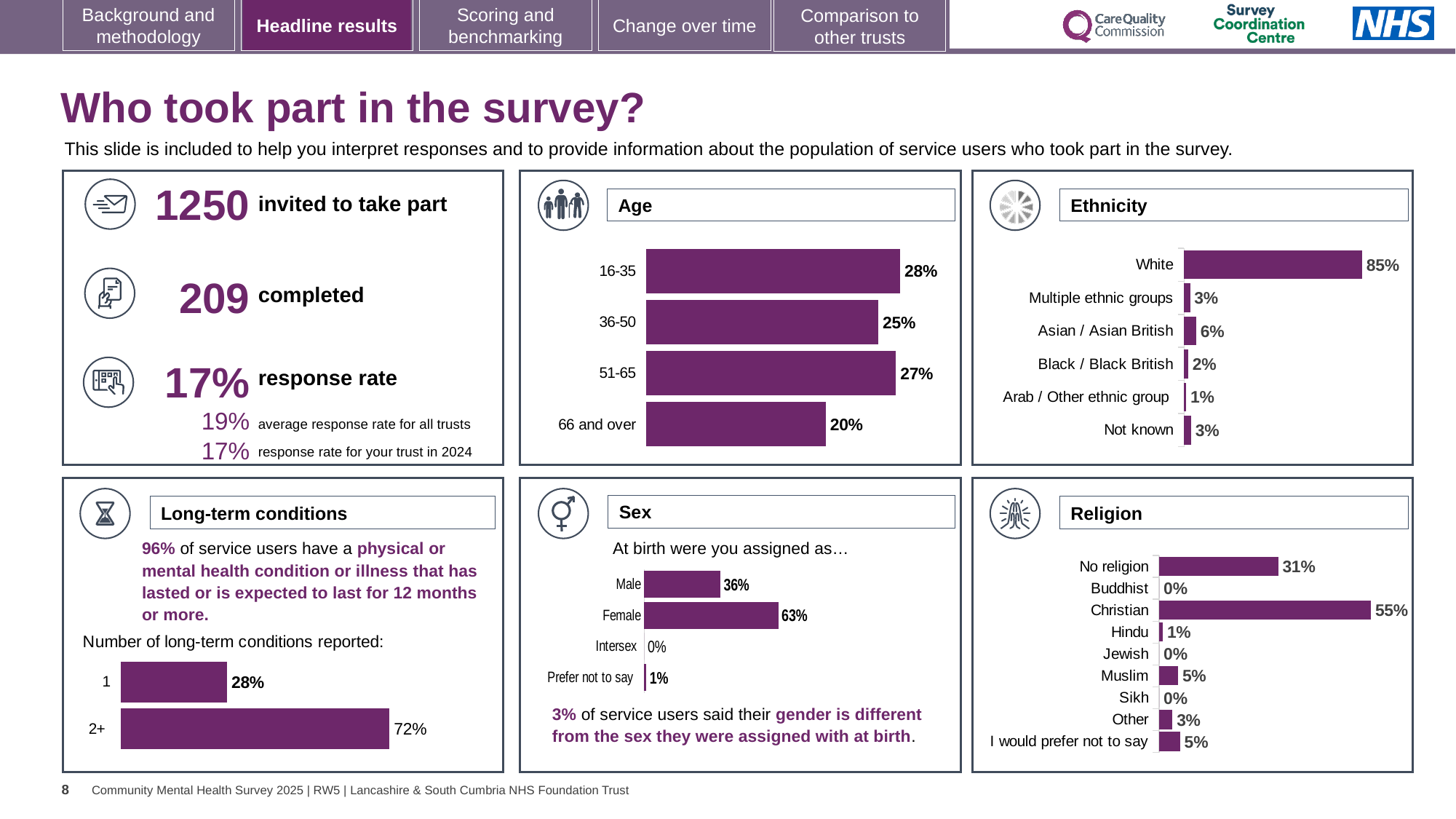
In the Age chart, what is the difference between the 51-65 and 36-50 percentages? 2% In the Ethnicity chart, which category has the lowest percentage? Arab / Other ethnic group In the Religion chart, what percentage of respondents reported No religion? 31% How many categories are shown in the Ethnicity chart? 6 In the Sex chart, what percentage of respondents were assigned Female at birth? 63% In the Ethnicity chart, what percentage of respondents were White? 85% In the Sex chart, which is larger, Male or Female? Female In the Age chart, what percentage of respondents were aged 16-35? 28% In the Age chart, which age group has the lowest percentage? 66 and over In the Religion chart, which religion category has the highest percentage? Christian What type of chart is used in the Age panel? Bar chart In the Long-term conditions chart, what percentage of service users reported 2+ conditions? 72%